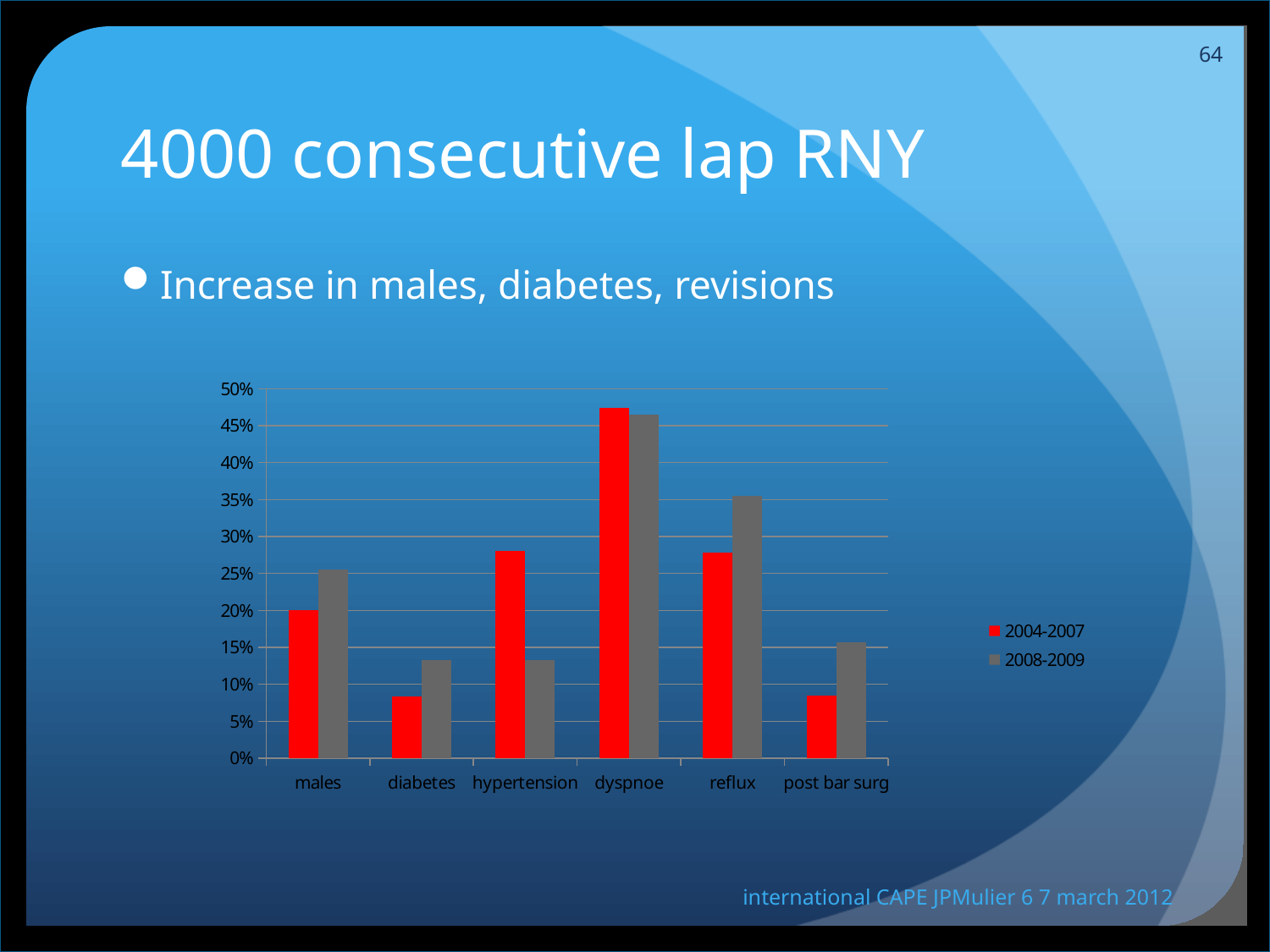
Is the 2004-2007 value for diabetes greater or less than 10%? less Which colour represents the 2004-2007 series in the chart? red For males, which series has the larger value, 2004-2007 or 2008-2009? 2008-2009 How many categories are shown on the x axis of the chart? 6 For hypertension, which series has the larger value, 2004-2007 or 2008-2009? 2004-2007 Which category has the highest value for the 2008-2009 series? dyspnoe How many series does the chart legend list? 2 Is the 2004-2007 value for dyspnoe greater or less than 45%? greater Is the 2008-2009 value for hypertension greater or less than 15%? less What kind of chart is shown on the slide? bar chart For reflux, which series has the larger value, 2004-2007 or 2008-2009? 2008-2009 Which category has the highest value for the 2004-2007 series? dyspnoe